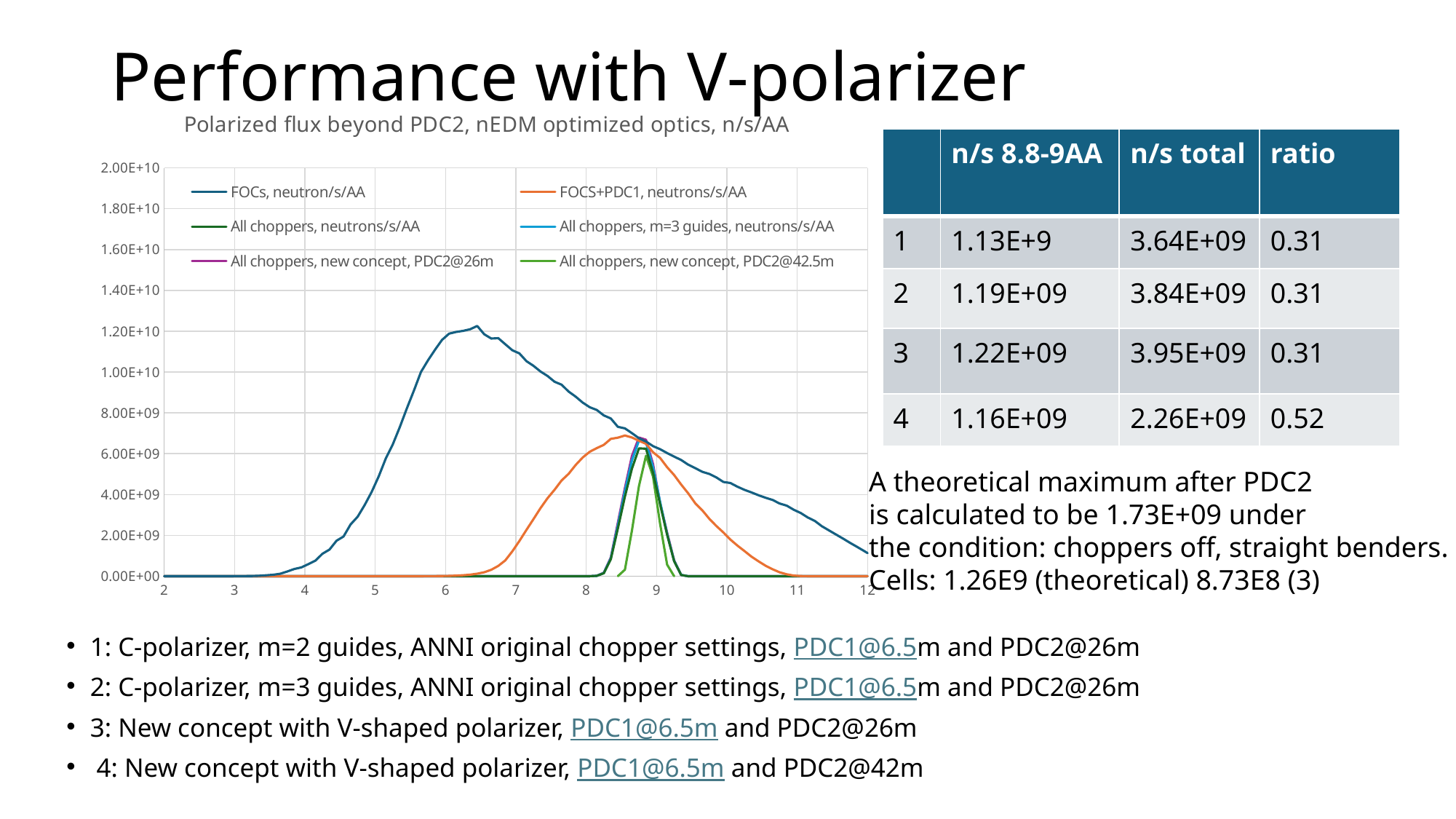
Which series has the higher peak: FOCs, neutron/s/AA or FOCS+PDC1, neutrons/s/AA? FOCs, neutron/s/AA How many series does the chart legend list? 6 Does the FOCs, neutron/s/AA series rise or fall between x = 7 and x = 12? fall Is the peak value of the FOCs, neutron/s/AA series greater or less than 1.40E+10? less Is the value of the FOCs, neutron/s/AA series at x = 4 greater or less than 2.00E+09? less Is the value of the FOCs, neutron/s/AA series at x = 6 greater or less than 1.00E+10? greater What is the maximum value shown on the chart's y axis? 2.00E+10 What is the title of the chart? Polarized flux beyond PDC2, nEDM optimized optics, n/s/AA Which series reaches the highest value on the chart? FOCs, neutron/s/AA What kind of chart is shown on the slide? line chart